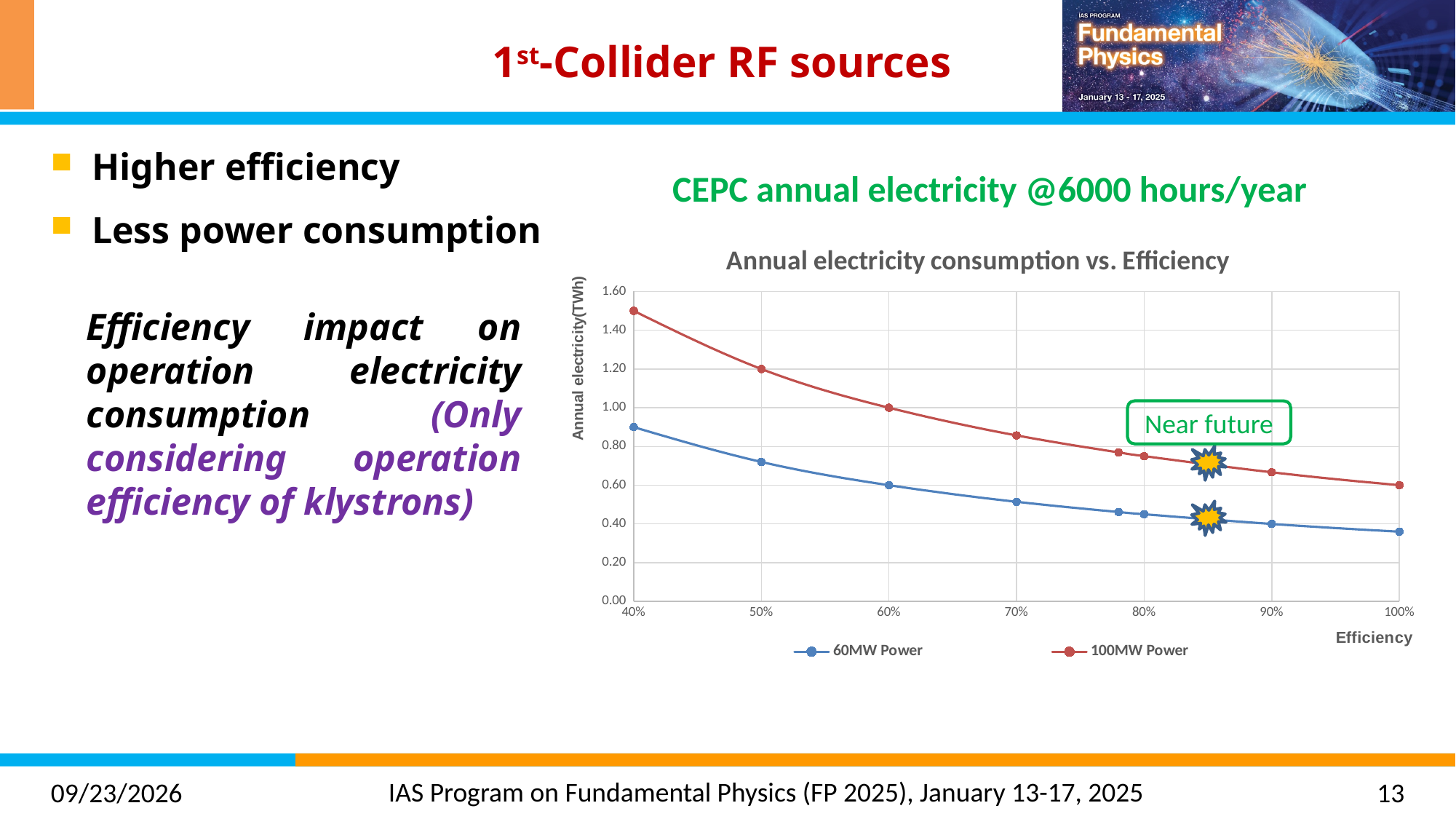
What kind of chart is shown on the slide? line chart What is the title of the chart? Annual electricity consumption vs. Efficiency What is the annual electricity consumption for 60MW Power at 90% efficiency? 0.40 What is the annual electricity consumption for 60MW Power at 60% efficiency? 0.60 What is the annual electricity consumption for 100MW Power at 50% efficiency? 1.20 Do the values of the 100MW Power series rise or fall as efficiency increases along the x axis? fall How many series does the chart legend list? 2 What is the label of the vertical axis of the chart? Annual electricity(TWh) Is the value for 100MW Power at 40% efficiency greater or less than 1.40? greater Is the value for 60MW Power at 70% efficiency greater or less than 0.60? less What is the annual electricity consumption for 100MW Power at 100% efficiency? 0.60 At 50% efficiency, which series has the higher annual electricity consumption, 60MW Power or 100MW Power? 100MW Power